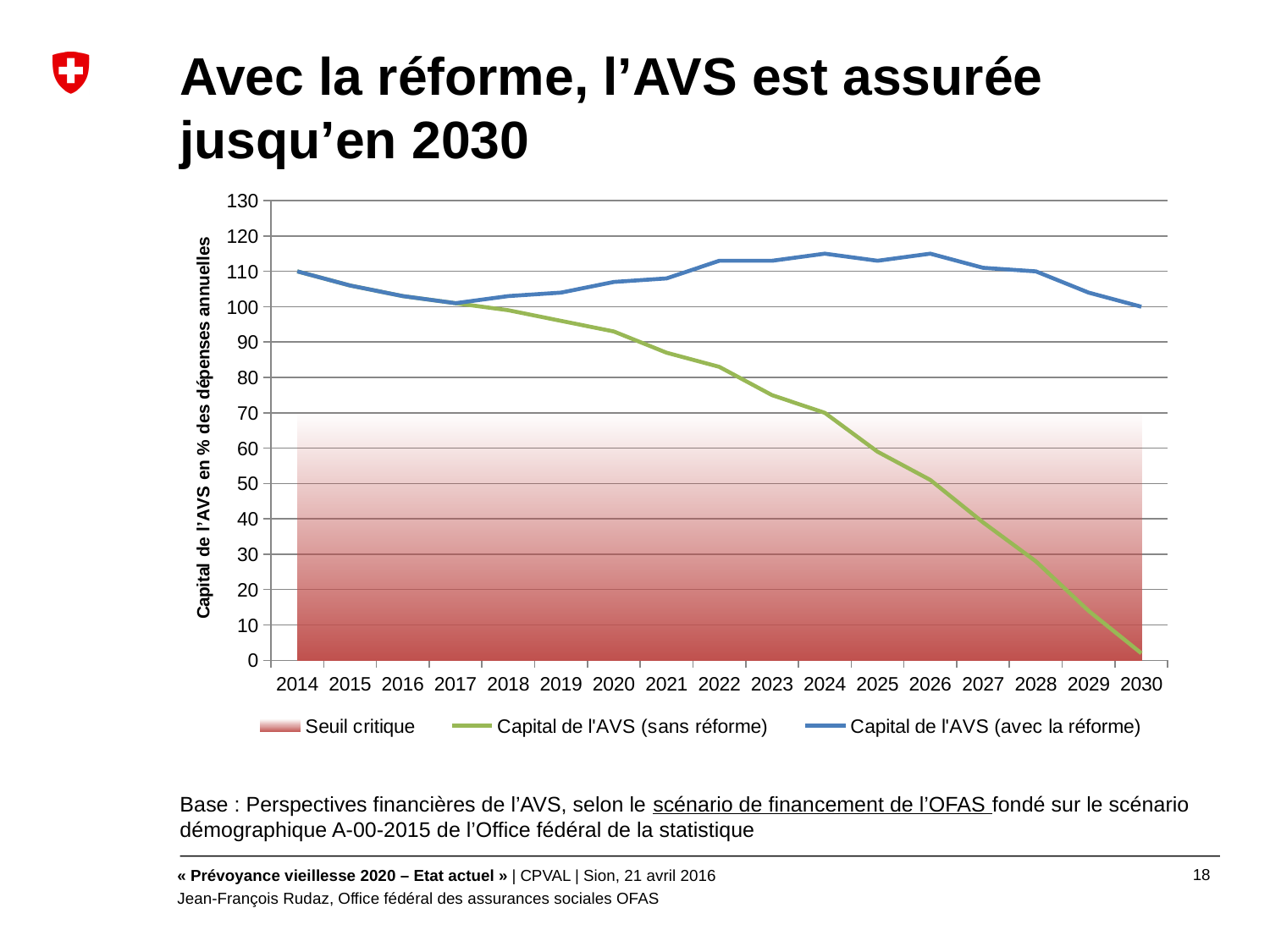
What kind of chart is shown on the slide? line chart Is the value for 'Capital de l'AVS (sans réforme)' in 2020 greater or less than 90? greater In 2030, which series is larger: 'Capital de l'AVS (sans réforme)' or 'Capital de l'AVS (avec la réforme)'? Capital de l'AVS (avec la réforme) Is the value for 'Capital de l'AVS (avec la réforme)' in 2024 greater or less than 110? greater What is the value of 'Capital de l'AVS (avec la réforme)' in 2030? 100 Is the value for 'Capital de l'AVS (sans réforme)' in 2030 greater or less than 10? less How many entries does the legend list? 3 What is the label of the y axis? Capital de l'AVS en % des dépenses annuelles How many years are shown on the x axis? 17 In which year is 'Capital de l'AVS (sans réforme)' at its lowest? 2030 Does 'Capital de l'AVS (sans réforme)' rise or fall from 2017 to 2030? fall